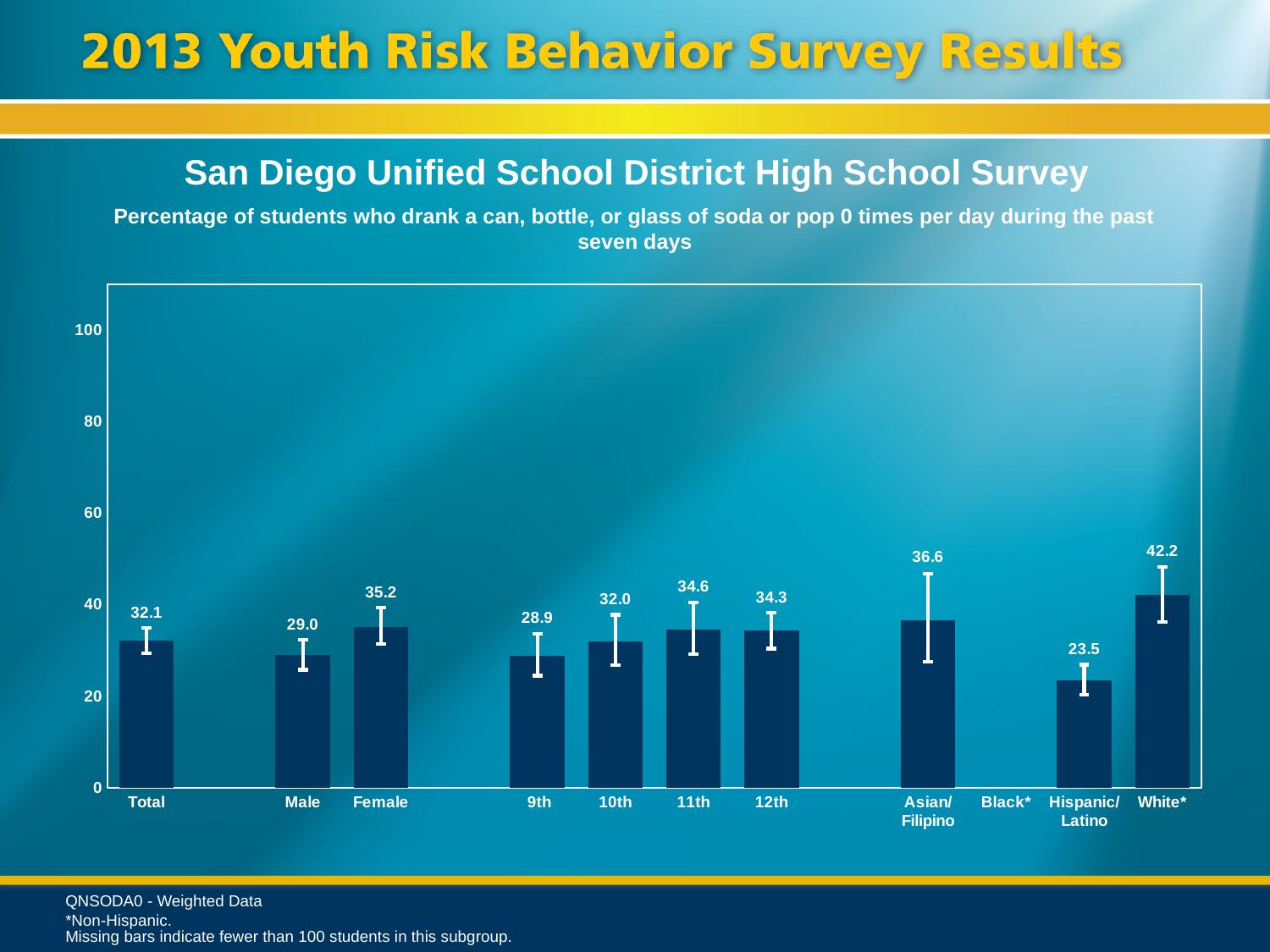
What is the difference between the Female and Male values? 6.2 Which category with a bar has the lowest value? Hispanic/Latino Which category has no bar shown? Black* What is the value for Total? 32.1 How many categories have a bar plotted? 10 What kind of chart is shown? bar chart What is the value for Female? 35.2 What is the value for Asian/Filipino? 36.6 Which category has the highest value? White* What is the value for Hispanic/Latino? 23.5 Is the value for White* greater or less than 40? greater Which is larger, the value for 11th or the value for 9th? 11th